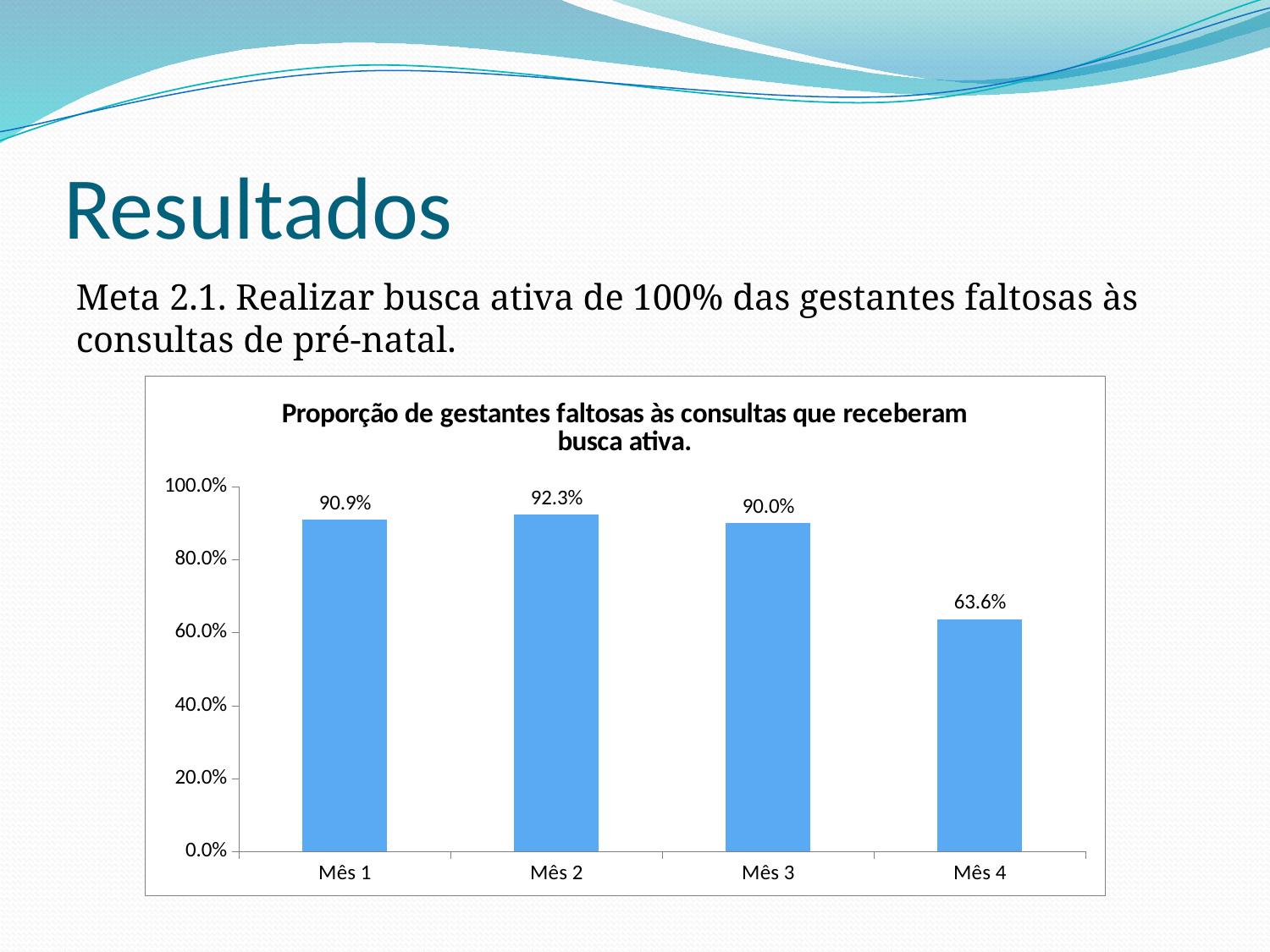
What is the title of the chart? Proporção de gestantes faltosas às consultas que receberam busca ativa. What is the value for Mês 3? 90.0% What is the difference between the values for Mês 2 and Mês 4? 28.7% Is the value for Mês 4 greater or less than 80.0%? less How many months are shown on the x axis? 4 Which month has the lowest value? Mês 4 What kind of chart is shown on the slide? bar chart Which is larger, the value for Mês 1 or the value for Mês 4? Mês 1 What is the value for Mês 4? 63.6% What is the value for Mês 1? 90.9% What is the value for Mês 2? 92.3% Which month has the highest value? Mês 2